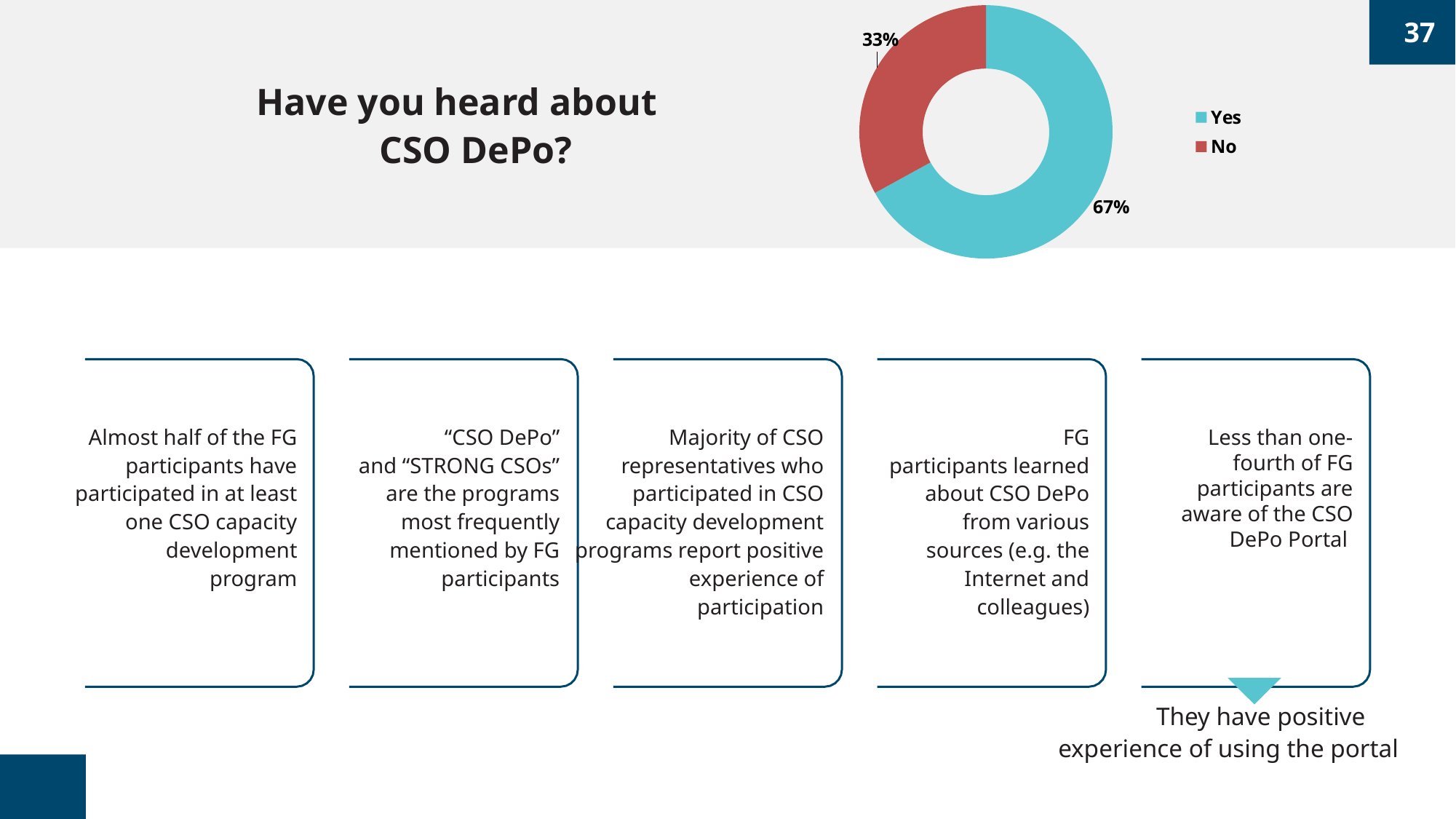
Which is larger, the share for Yes or the share for No? Yes What percentage of respondents answered Yes to having heard about CSO DePo? 67% Which response has the smallest share of the pie chart? No What is the difference in percentage points between the Yes and No shares? 34 How many categories does the pie chart show? 2 What kind of chart is shown on the slide? Pie chart (doughnut) What colour is the Yes slice in the pie chart? Blue What question does the chart title ask? Have you heard about CSO DePo? What share of the pie does the No slice represent? 33% How many entries does the legend list? 2 Which response has the largest share of the pie chart? Yes What percentage of respondents answered No to having heard about CSO DePo? 33%